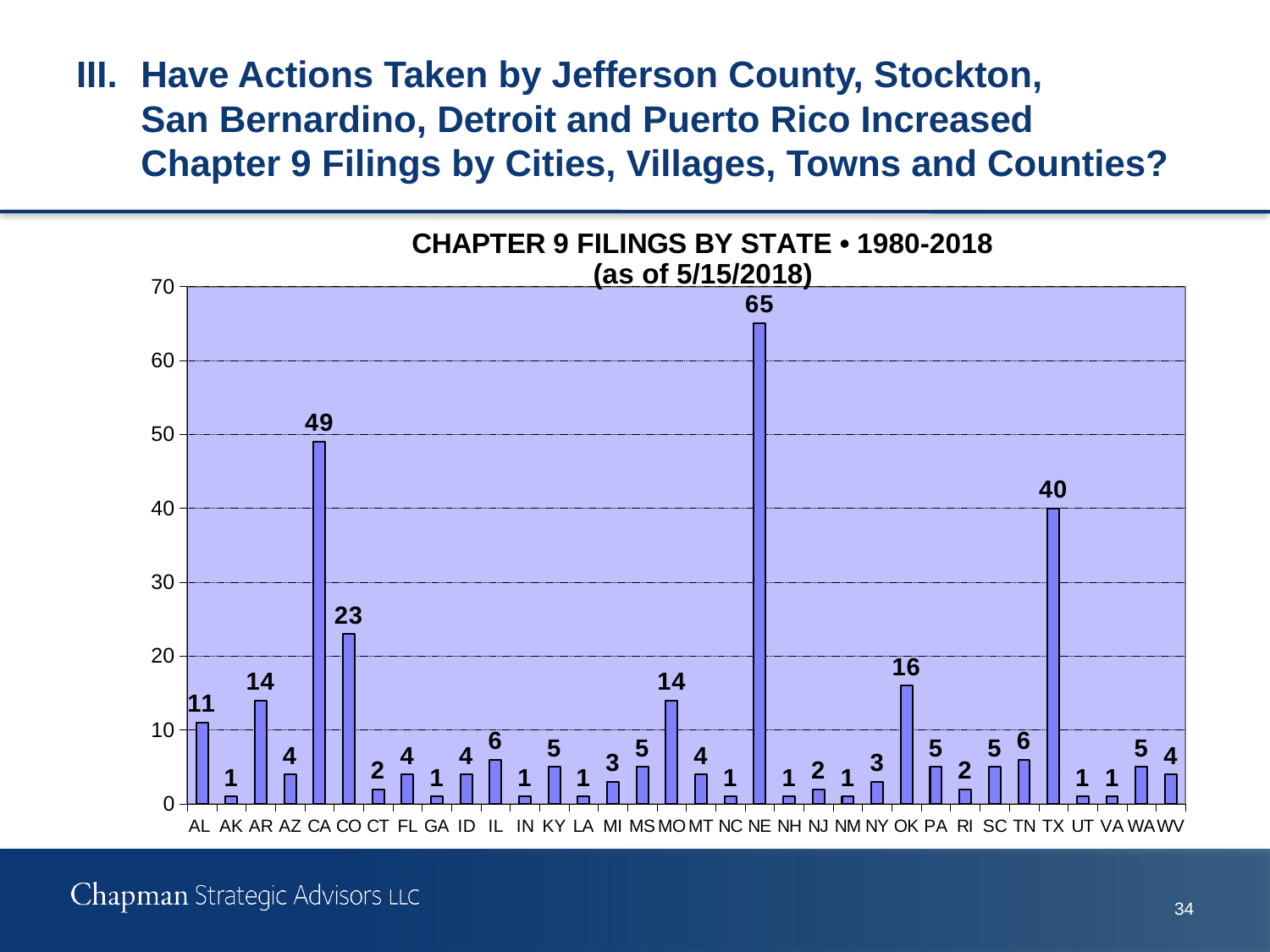
What is the value shown for OK? 16 Is the value for TX greater or less than 30? greater Which is larger, the value for CO or the value for OK? CO What is the difference between the values for NE and CA? 16 What is the value for NE in the Chapter 9 Filings by State chart? 65 What is the difference between the values for CA and TX? 9 What kind of chart is shown on the slide? bar chart What is the value shown for TX? 40 Which state has the highest number of Chapter 9 filings in the chart? NE What is the title of the chart? CHAPTER 9 FILINGS BY STATE • 1980-2018 (as of 5/15/2018) How many states are shown on the x axis of the chart? 34 How many Chapter 9 filings does the chart show for CA? 49